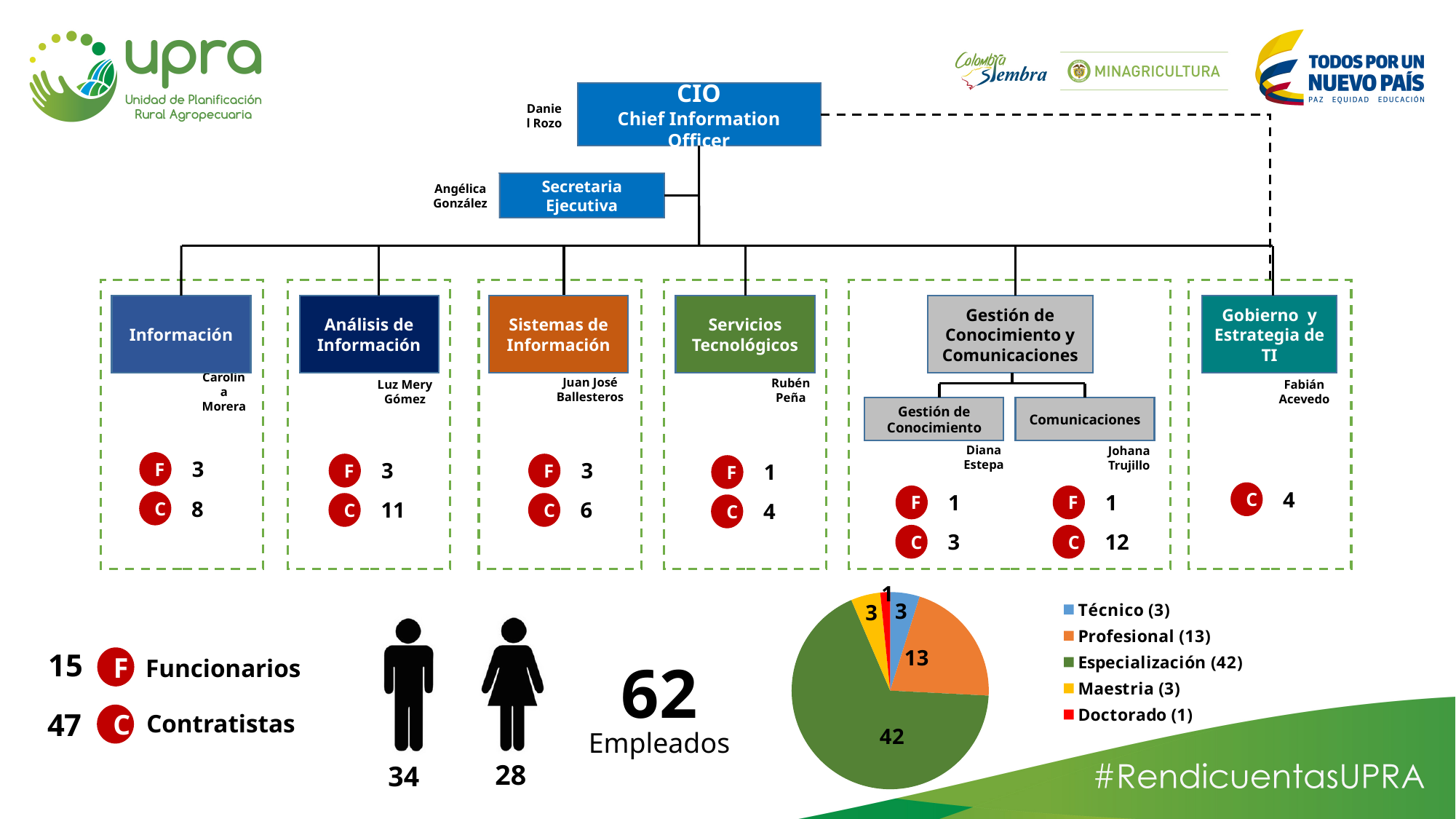
Which category has the smallest slice in the pie chart? Doctorado What colour is the Especialización slice in the pie chart? green In the pie chart, what is the value for Especialización? 42 How many categories does the pie chart's legend list? 5 In the pie chart, what is the value for Técnico? 3 Which category has the largest slice in the pie chart? Especialización In the pie chart, which is larger, Profesional or Maestria? Profesional In the pie chart, what is the difference between the values for Especialización and Profesional? 29 What is the total of all the slices in the pie chart? 62 In the pie chart, what is the value for Profesional? 13 In the pie chart, what is the value for Doctorado? 1 What kind of chart is shown at the bottom of the slide? pie chart